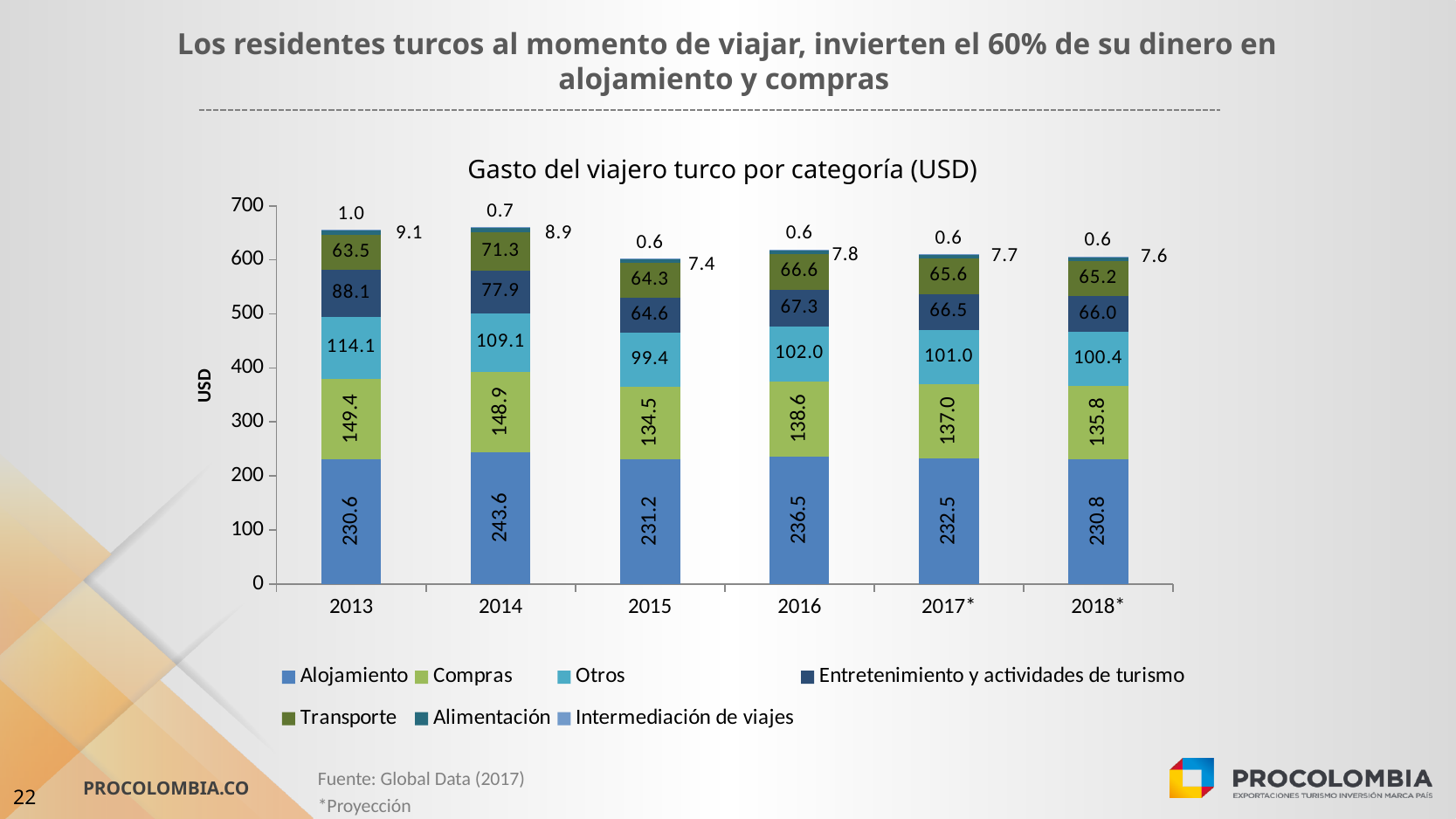
Is the total of the 2013 stacked bar greater or less than 600? greater In which year is the Otros value lowest? 2015 How many series does the legend list? 7 How many years are shown on the x axis? 6 What is the title of the chart? Gasto del viajero turco por categoría (USD) Which is larger, the Compras value in 2013 or in 2016? 2013 What is the difference between the Alojamiento values for 2014 and 2013? 13.0 What kind of chart is shown? Stacked bar chart What is the value for Alojamiento in 2014? 243.6 What is the value for Otros in 2016? 102.0 What is the value for Transporte in 2018*? 65.2 In which year is the Alojamiento value highest? 2014